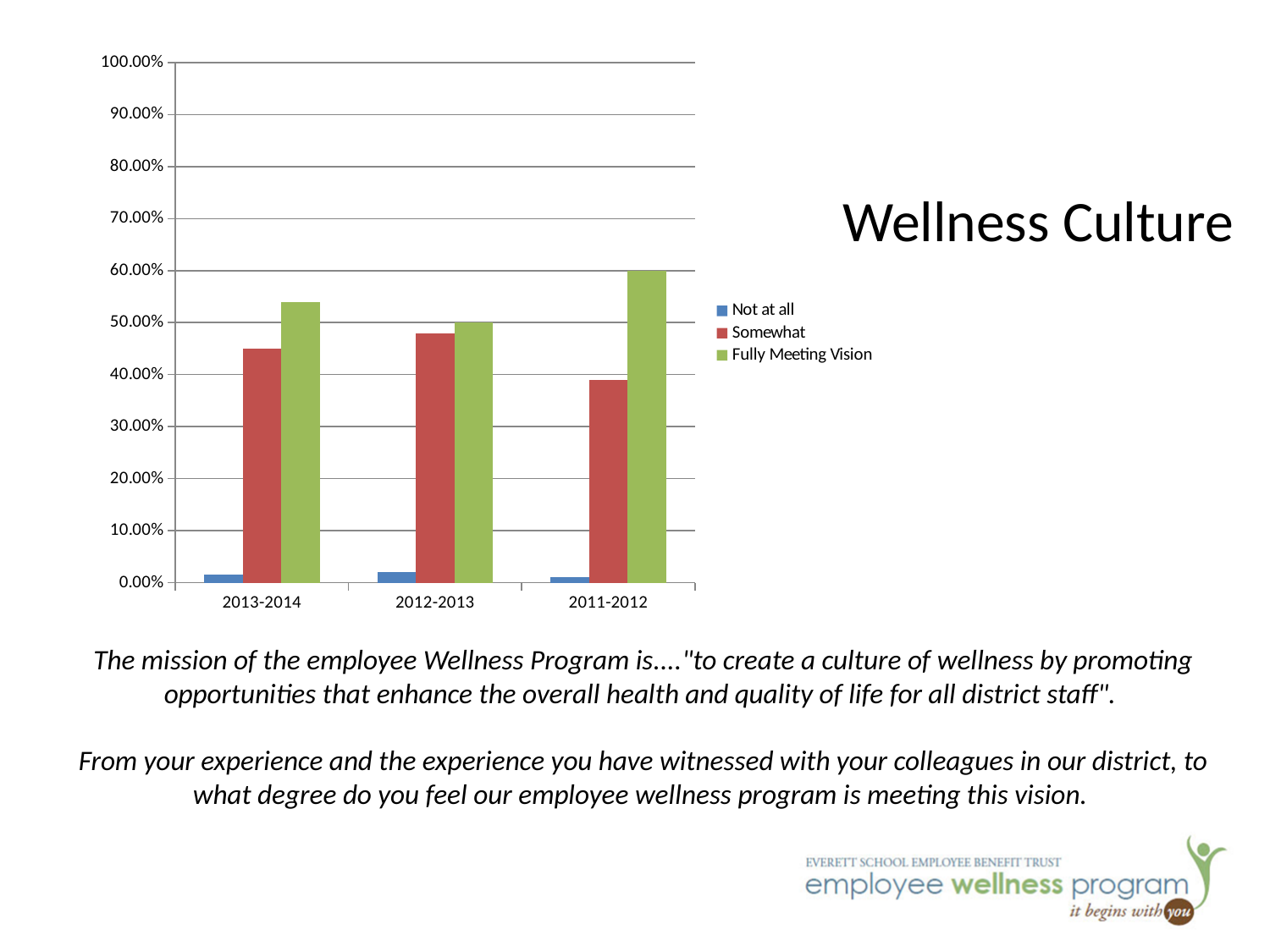
Which school year has the lowest value for Somewhat? 2011-2012 For 2013-2014, which is larger: Somewhat or Fully Meeting Vision? Fully Meeting Vision What kind of chart is shown on the slide? bar chart What is the title shown next to the chart? Wellness Culture Which school year has the highest value for Fully Meeting Vision? 2011-2012 Is the value for Not at all in 2012-2013 greater or less than 10.00%? less Which school year has the highest value for Somewhat? 2012-2013 How many school-year categories are shown on the x axis? 3 Is the value for Fully Meeting Vision in 2013-2014 greater or less than 50.00%? greater How many series does the legend list? 3 Which school year has the lowest value for Fully Meeting Vision? 2012-2013